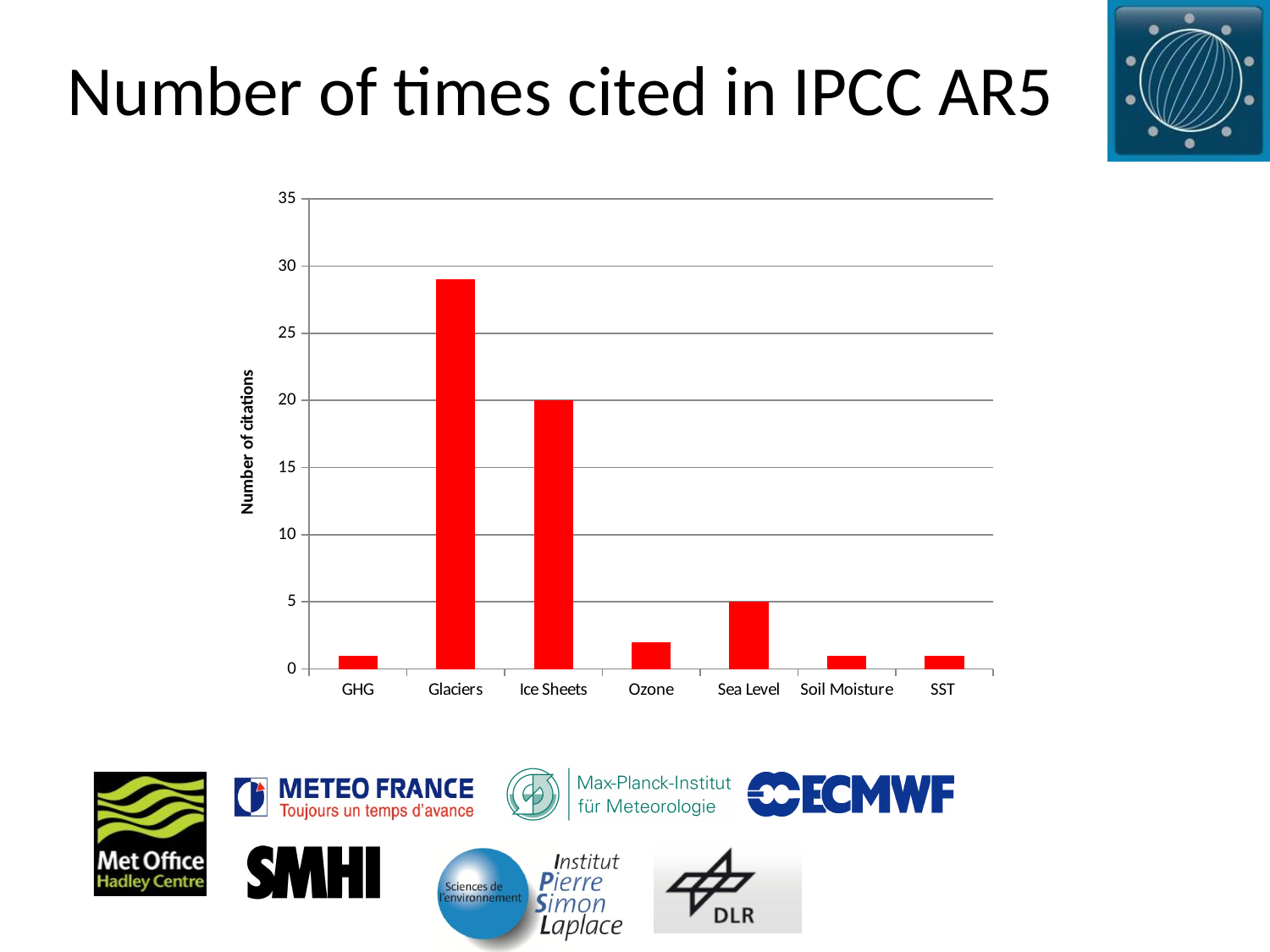
Which has more citations, Glaciers or Ice Sheets? Glaciers What is the difference in number of citations between Ice Sheets and Sea Level? 15 Is the value for Ozone greater or less than 5? less Which has more citations, Sea Level or Ozone? Sea Level What is the label on the vertical axis of the chart? Number of citations What colour are the bars in the chart? red What type of chart is shown on the slide? bar chart How many categories are shown on the x axis of the chart? 7 What is the number of citations for Ice Sheets? 20 Which category has the highest number of citations? Glaciers Is the value for Glaciers greater or less than 25? greater What is the number of citations for Sea Level? 5